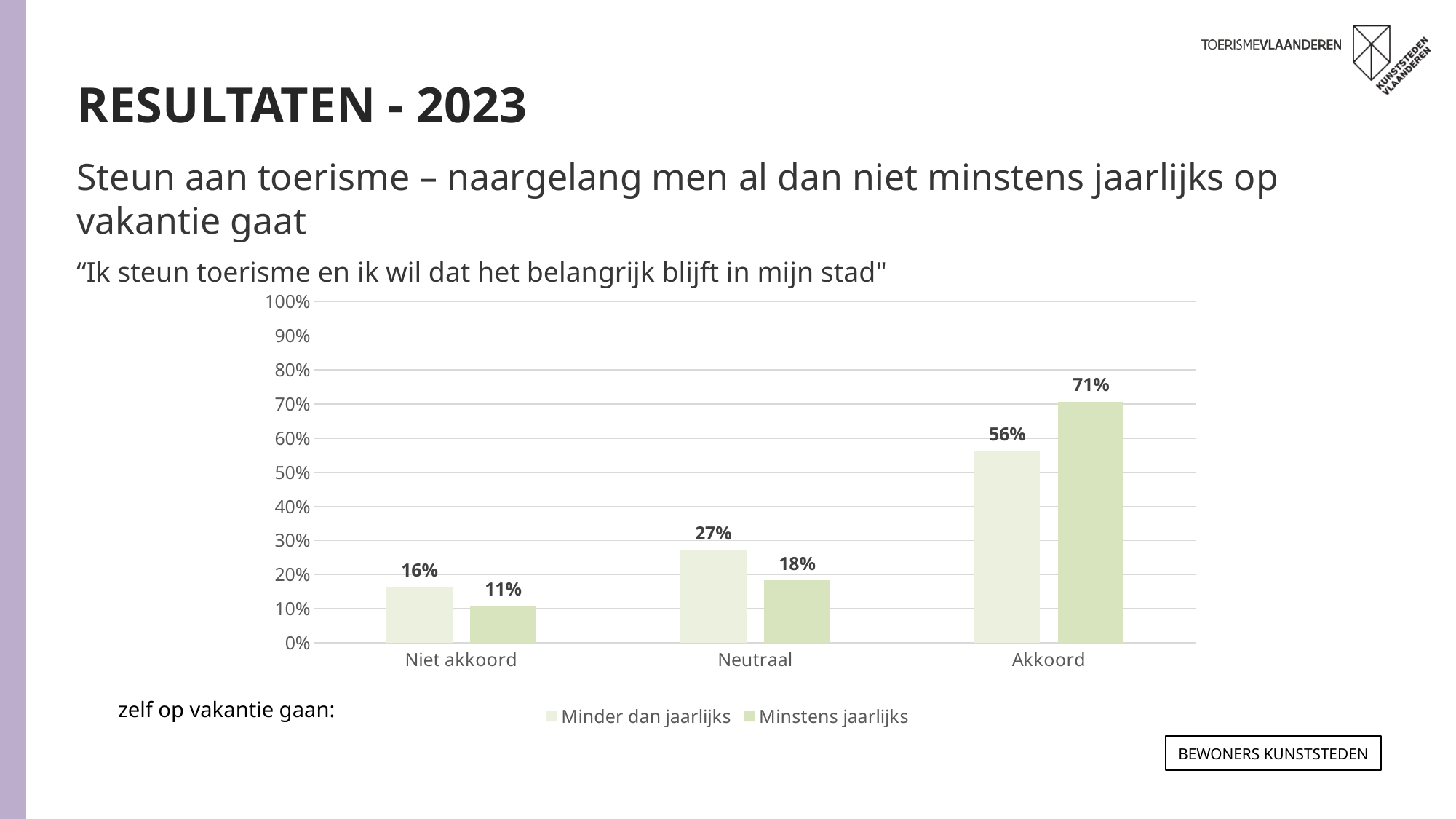
Which category has the highest value for the 'Minstens jaarlijks' series? Akkoord What is the value for 'Minstens jaarlijks' in the 'Niet akkoord' category? 11% What is the value for 'Minder dan jaarlijks' in the 'Neutraal' category? 27% Which category has the lowest value for the 'Minder dan jaarlijks' series? Niet akkoord What kind of chart is shown on the slide? bar chart In the 'Neutraal' category, which series has the larger value? Minder dan jaarlijks Is the value for 'Minstens jaarlijks' in the 'Akkoord' category greater or less than 60%? greater What statement is the chart about, as shown above the chart? "Ik steun toerisme en ik wil dat het belangrijk blijft in mijn stad" What is the difference between 'Minstens jaarlijks' and 'Minder dan jaarlijks' in the 'Akkoord' category? 15% What is the value for 'Minder dan jaarlijks' in the 'Akkoord' category? 56% How many series does the legend list? 2 How many categories are shown on the x axis? 3